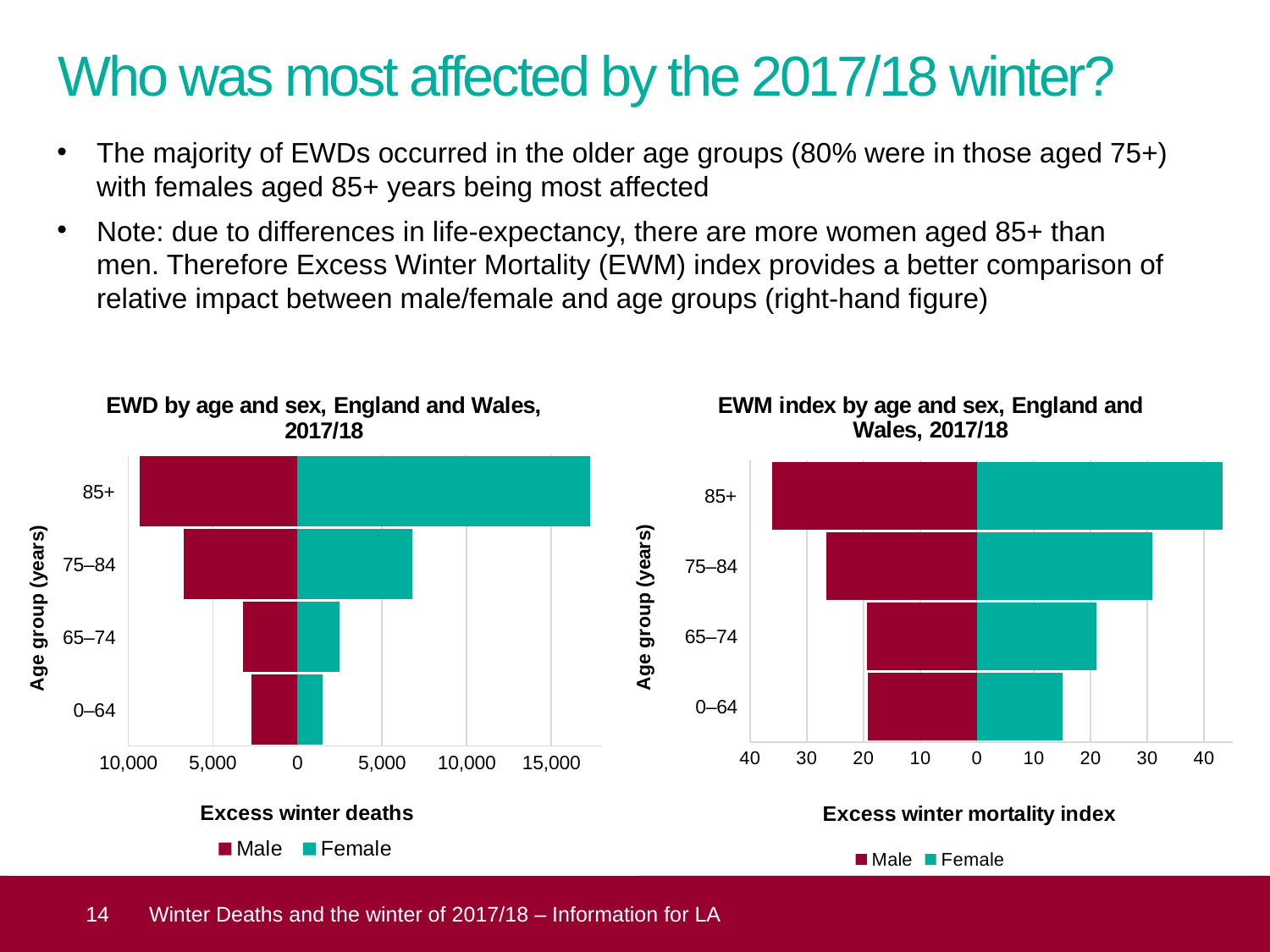
On the right chart (EWM index by age and sex), is the Female value for 85+ greater or less than 40? greater On the right chart (EWM index by age and sex), is the Female value for 0–64 greater or less than 20? less On the right chart (EWM index by age and sex), is the Male value for 85+ greater or less than 30? greater How many age groups are shown on the left chart (EWD by age and sex)? 4 On the left chart (EWD by age and sex), which age group has the lowest Female value? 0–64 On the right chart (EWM index by age and sex), for the 0–64 age group, is the Male or Female value larger? Male On the left chart (EWD by age and sex), which age group has the highest Female value? 85+ On the left chart (EWD by age and sex), for the 85+ age group, is the Male or Female value larger? Female How many series does the legend of the right chart (EWM index by age and sex) list? 2